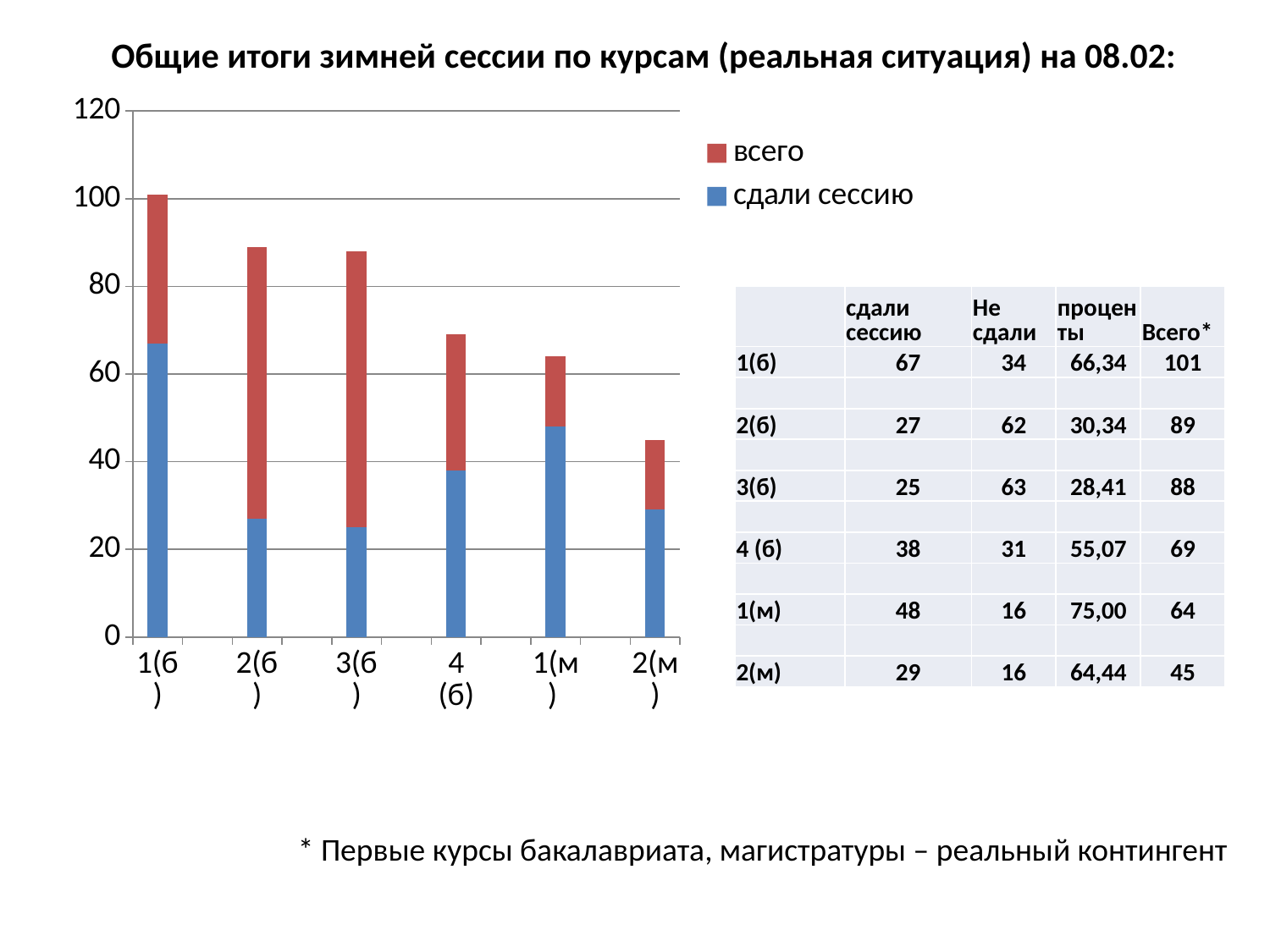
According to the table on the slide, what is the total ('Всего*') for 2(м)? 45 Is the top of the stacked bar for 3(б) greater or less than 80? greater Which category has the tallest stacked bar in the chart? 1(б) Is the value of 'сдали сессию' for 2(б) greater or less than 40? less What kind of chart is shown on the slide? Stacked bar chart How many categories are shown on the x axis of the chart? 6 Which category has the shortest stacked bar in the chart? 2(м) Which has the larger 'сдали сессию' value, 1(м) or 4 (б)? 1(м) Do the heights of the stacked bars rise or fall from left to right along the x axis? fall According to the table on the slide, what is the 'сдали сессию' value for 1(б)? 67 How many series does the chart legend list? 2 What colour represents 'сдали сессию' in the chart legend? Blue